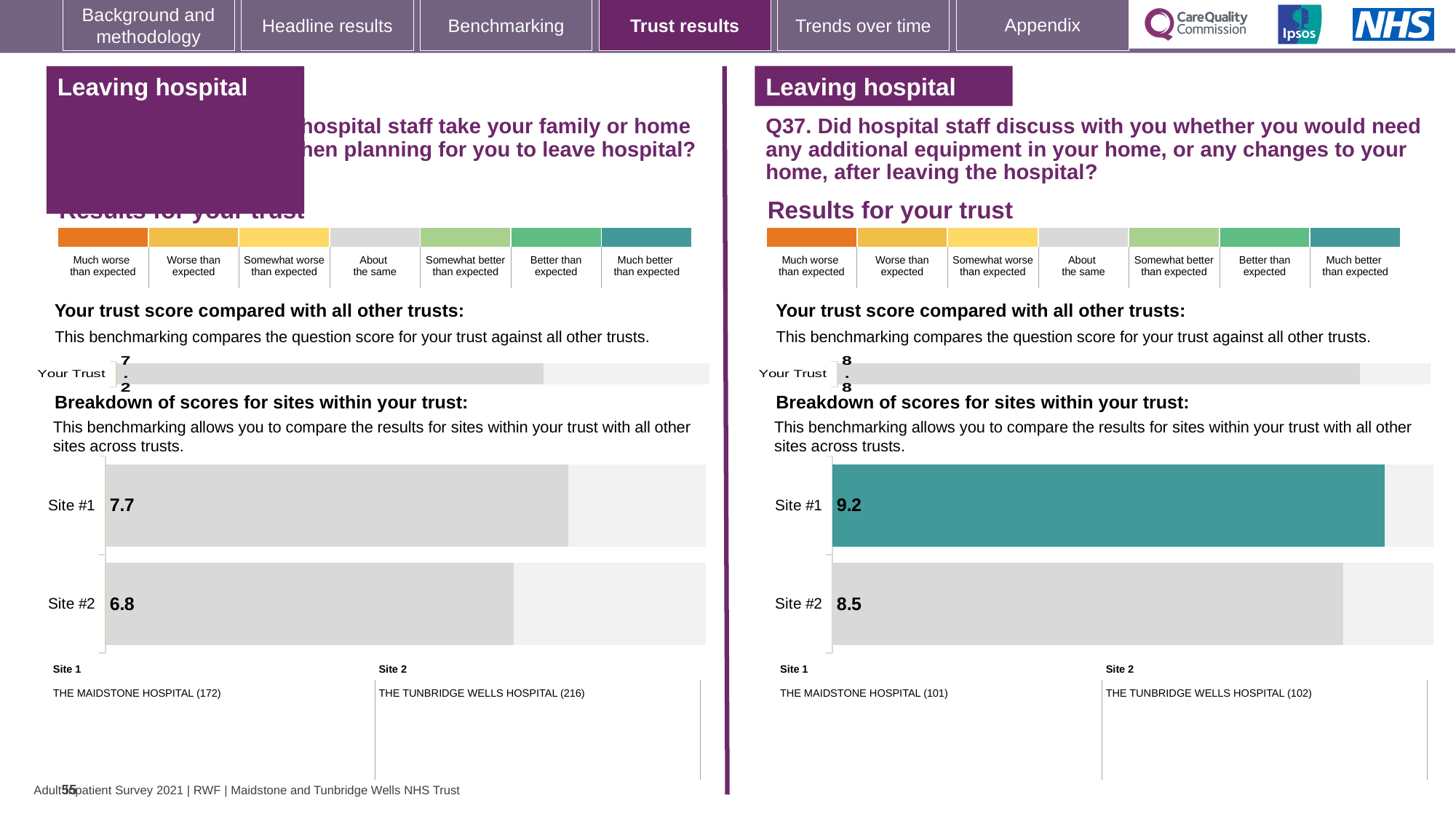
On the left-hand site breakdown chart, what is the score for Site #1? 7.7 What type of chart is used for the site breakdown on the right-hand side (Q37)? Bar chart On the right-hand chart (Q37), what is the score for Site #2? 8.5 On the left-hand chart, what is the 'Your Trust' score? 7.2 On the right-hand chart (Q37), what is the difference between the Site #1 and Site #2 scores? 0.7 On the left-hand site breakdown chart, what is the score for Site #2? 6.8 On the right-hand chart (Q37), what is the 'Your Trust' score? 8.8 On the right-hand chart (Q37), which site has the higher score? Site #1 On the left-hand site breakdown chart, what is the difference between the Site #1 and Site #2 scores? 0.9 How many sites are shown in the site breakdown chart on the right-hand side (Q37)? 2 On the right-hand chart (Q37), what is the score for Site #1? 9.2 On the left-hand site breakdown chart, which site has the lower score? Site #2